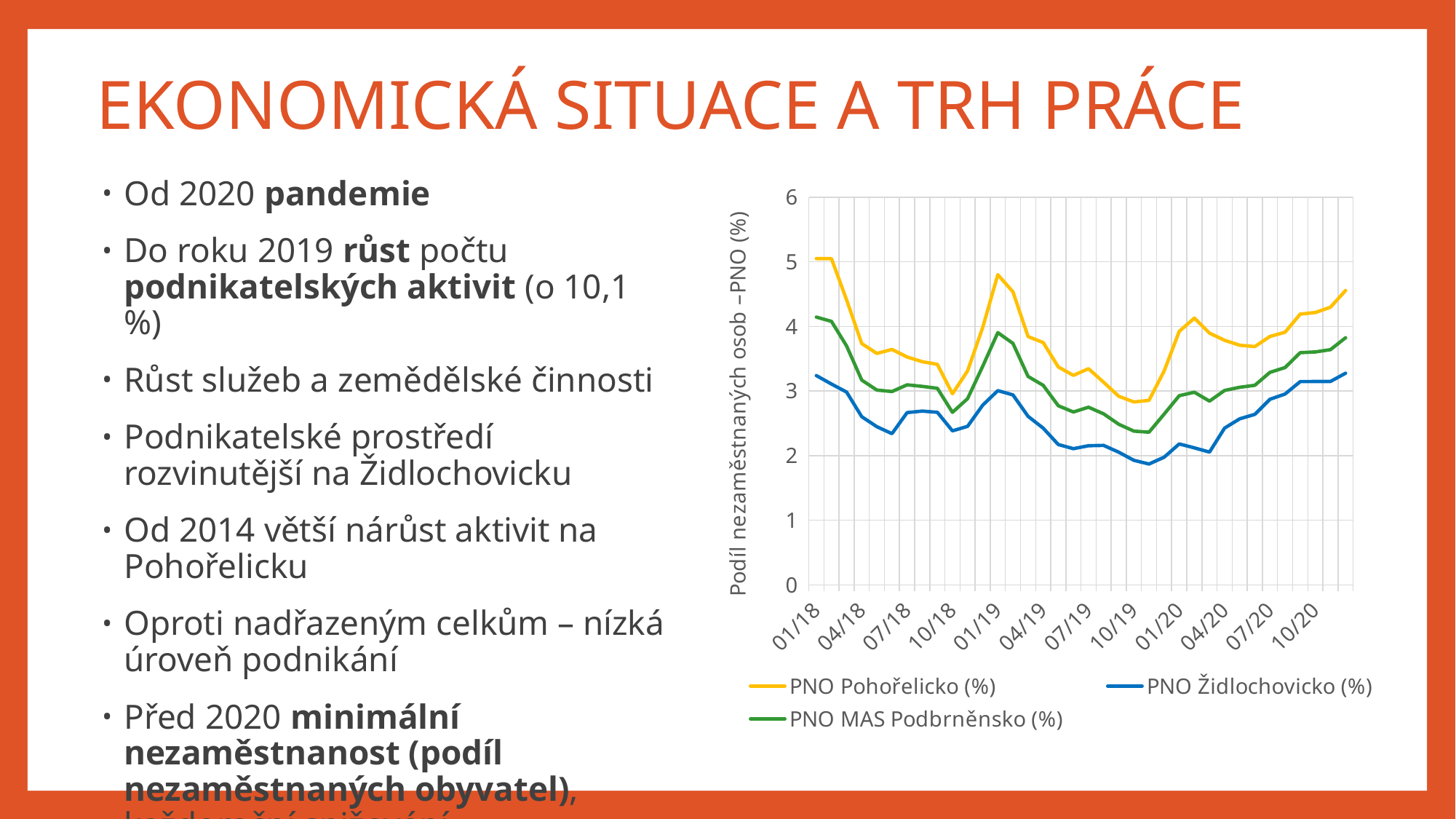
Is the value for PNO MAS Podbrněnsko (%) at 01/19 greater or less than 3? greater How many series does the chart legend list? 3 Does PNO Židlochovicko (%) rise or fall between 10/19 and the end of the series? rise What kind of chart is shown on the slide? line chart At 01/18, which is larger: PNO Pohořelicko (%) or PNO Židlochovicko (%)? PNO Pohořelicko (%) Is the value for PNO Pohořelicko (%) at 01/19 greater or less than 4? greater Which series has the lowest values across the whole period shown in the chart? PNO Židlochovicko (%) Which series has the highest values across the whole period shown in the chart? PNO Pohořelicko (%) What is the title of the vertical axis of the chart? Podíl nezaměstnaných osob – PNO (%) Is the value for PNO Židlochovicko (%) at 10/19 greater or less than 3? less Does PNO Pohořelicko (%) rise or fall between 01/18 and 07/18? fall